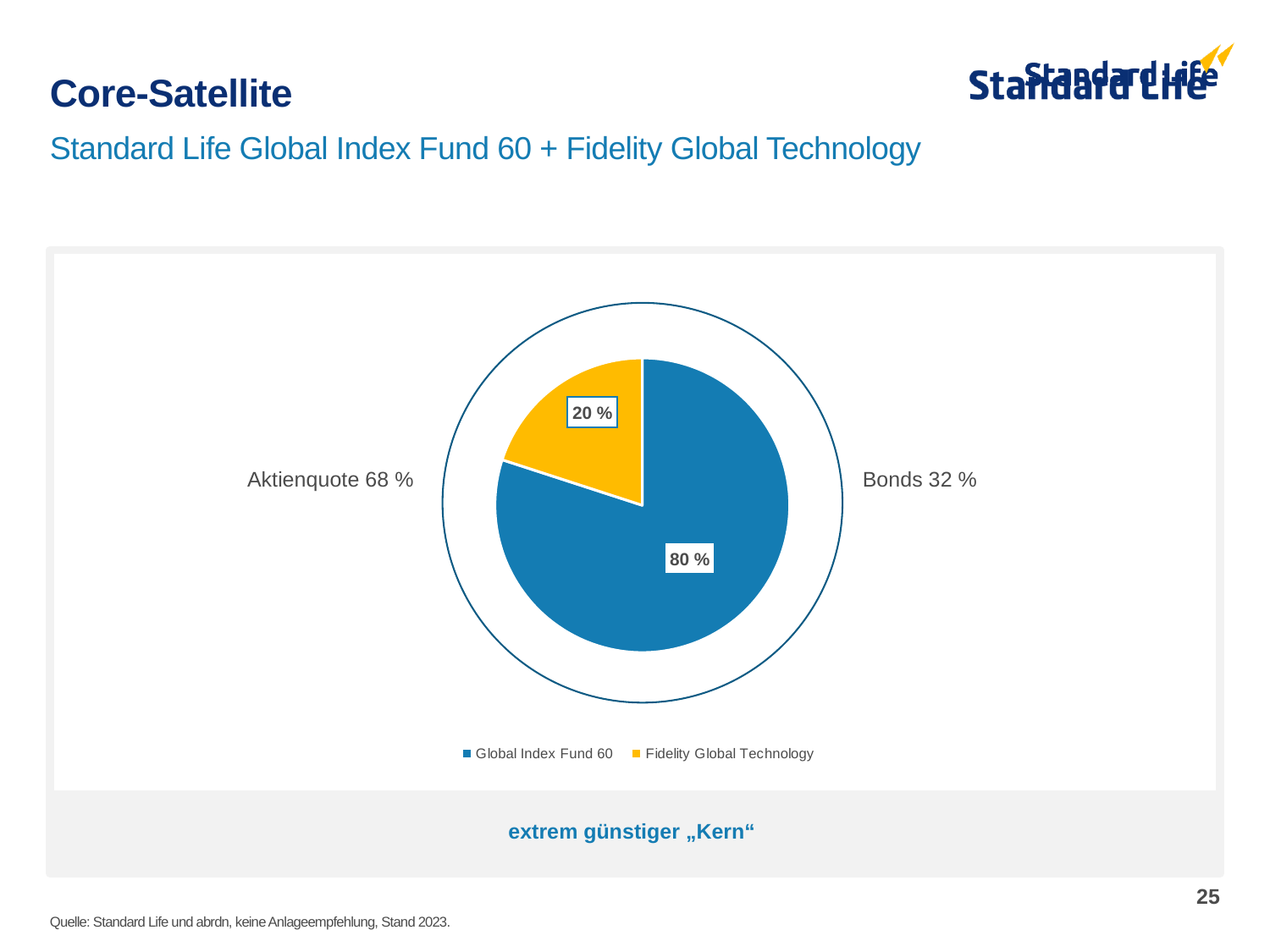
What share of the pie does Fidelity Global Technology have? 20 % What is the difference in percentage points between the Global Index Fund 60 slice and the Fidelity Global Technology slice? 60 What is the Aktienquote shown next to the pie chart? 68 % Which slice of the pie is the largest? Global Index Fund 60 What kind of chart is shown on the slide? Pie chart What share of the pie does Global Index Fund 60 have? 80 % What colour is the Fidelity Global Technology slice? Yellow Which is larger, the Global Index Fund 60 slice or the Fidelity Global Technology slice? Global Index Fund 60 Which slice of the pie is the smallest? Fidelity Global Technology How many slices does the pie chart have? 2 How many entries does the legend list? 2